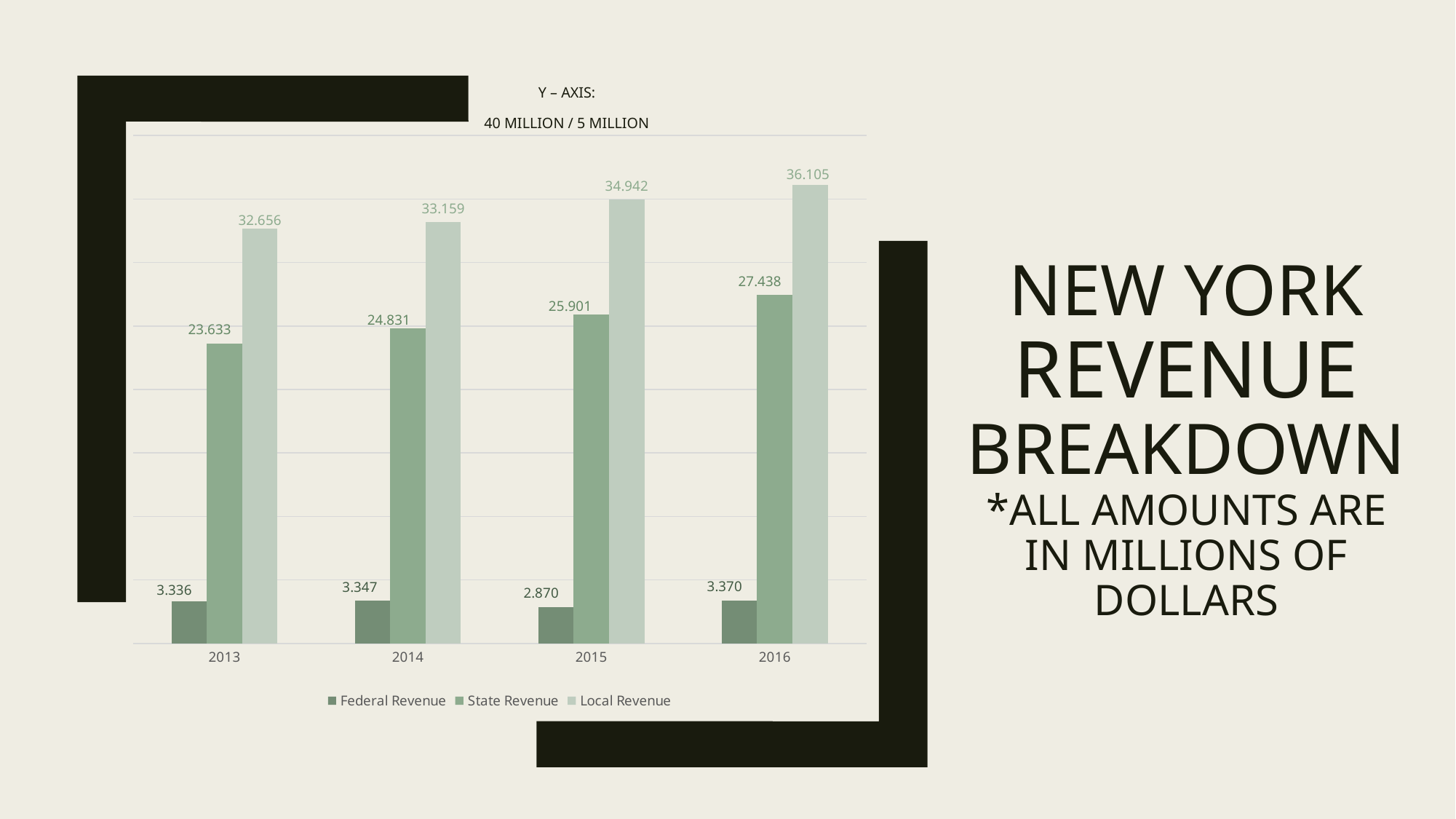
What is the Federal Revenue value for 2015? 2.870 What is the Local Revenue value for 2016? 36.105 Which is larger, State Revenue in 2015 or Local Revenue in 2013? Local Revenue in 2013 By how much did Local Revenue increase from 2013 to 2016? 3.449 What is the difference between Local Revenue and State Revenue in 2016? 8.667 What is the State Revenue value for 2014? 24.831 What kind of chart is shown on the slide? Bar chart How many years are shown on the x axis? 4 In which year is Local Revenue highest? 2016 How many series does the legend list? 3 In which year is Federal Revenue lowest? 2015 Does State Revenue rise or fall from 2013 to 2016? Rise